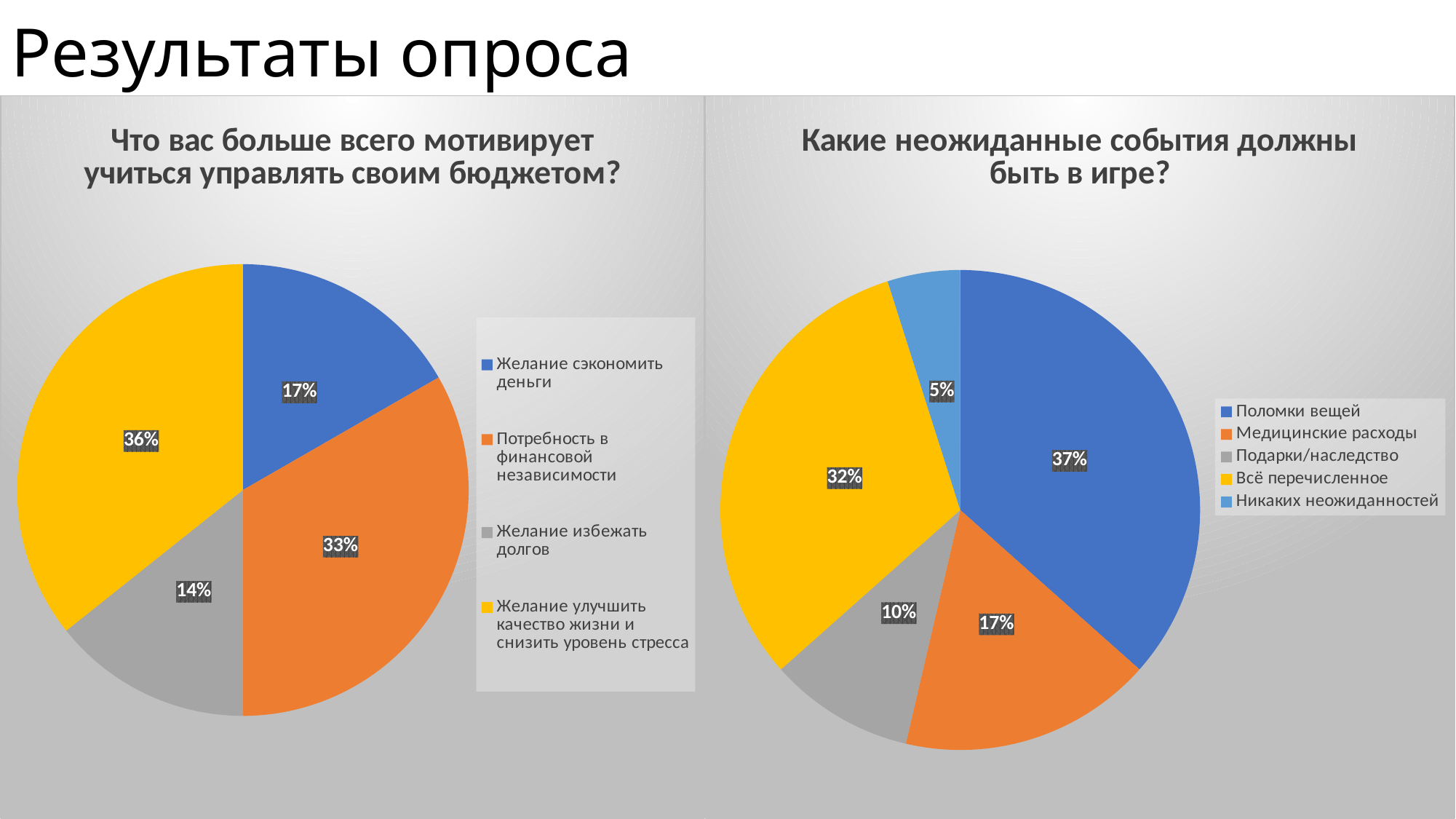
In the right chart, which category has the smallest slice? Никаких неожиданностей What type of chart is used for both charts on the slide? Pie chart In the left chart, which category has the largest slice? Желание улучшить качество жизни и снизить уровень стресса In the right chart, what share is labelled for "Никаких неожиданностей"? 5% In the right chart, which is larger: "Медицинские расходы" or "Подарки/наследство"? Медицинские расходы In the left chart ("Что вас больше всего мотивирует учиться управлять своим бюджетом?"), what share is labelled for "Желание сэкономить деньги"? 17% In the left chart, what is the difference in percentage points between "Желание улучшить качество жизни и снизить уровень стресса" and "Желание избежать долгов"? 22 How many categories does the left chart's legend list? 4 In the right chart ("Какие неожиданные события должны быть в игре?"), what share is labelled for "Поломки вещей"? 37% In the left chart, what share is labelled for "Потребность в финансовой независимости"? 33% In the left chart, which category has the smallest slice? Желание избежать долгов How many categories does the right chart's legend list? 5